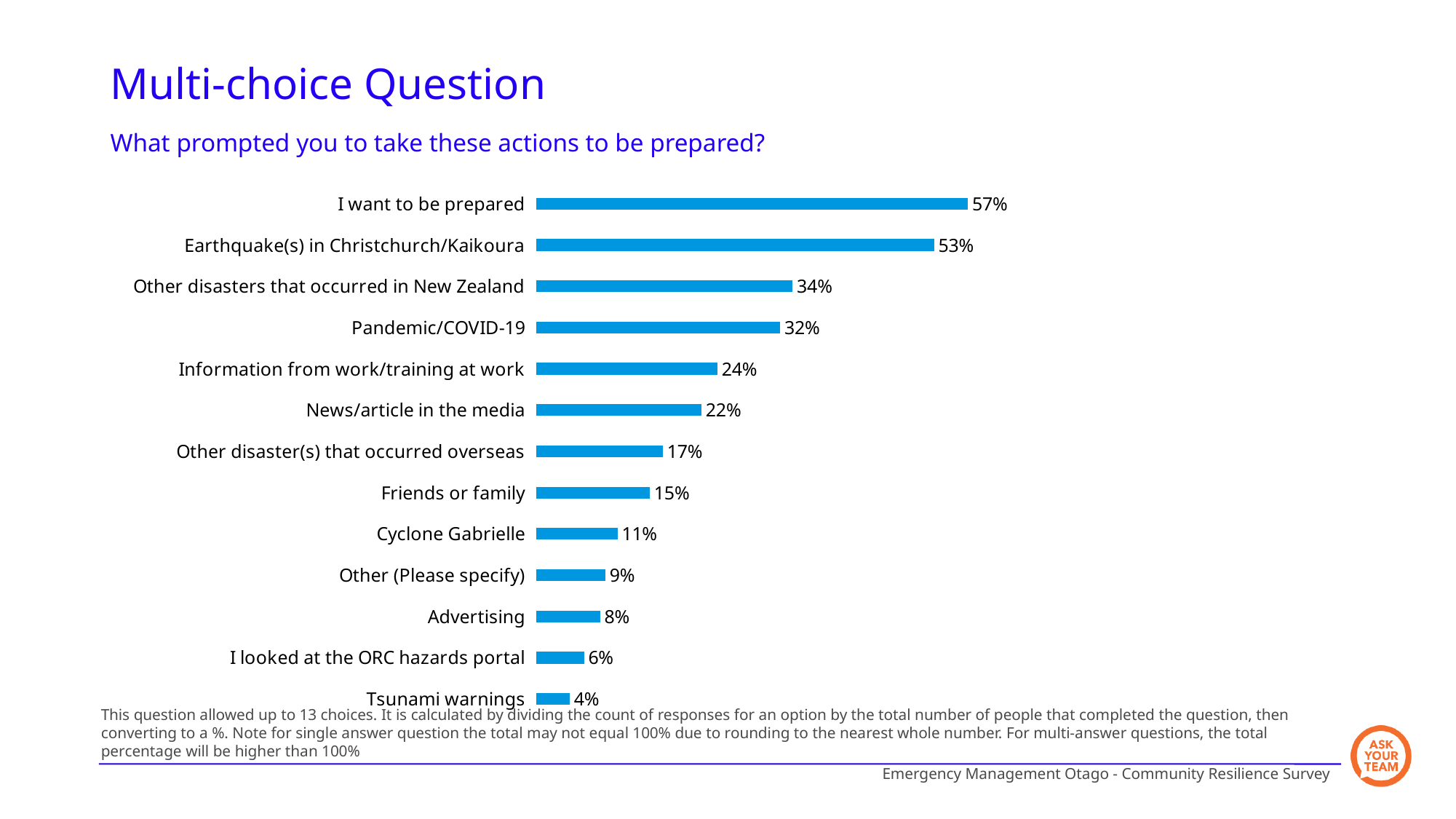
What value is shown for "Pandemic/COVID-19"? 32% What question does the chart present responses to? What prompted you to take these actions to be prepared? Which category has the lowest value? Tsunami warnings How many categories are shown in the chart? 13 What is the difference between "I want to be prepared" and "Earthquake(s) in Christchurch/Kaikoura"? 4% What percentage is shown for "Cyclone Gabrielle"? 11% What is the difference between "Information from work/training at work" and "Friends or family"? 9% What percentage of respondents selected "I want to be prepared"? 57% Which is larger: "Other disasters that occurred in New Zealand" or "Pandemic/COVID-19"? Other disasters that occurred in New Zealand Which is larger: "Advertising" or "I looked at the ORC hazards portal"? Advertising What type of chart is shown on the slide? Bar chart Which category has the highest value? I want to be prepared